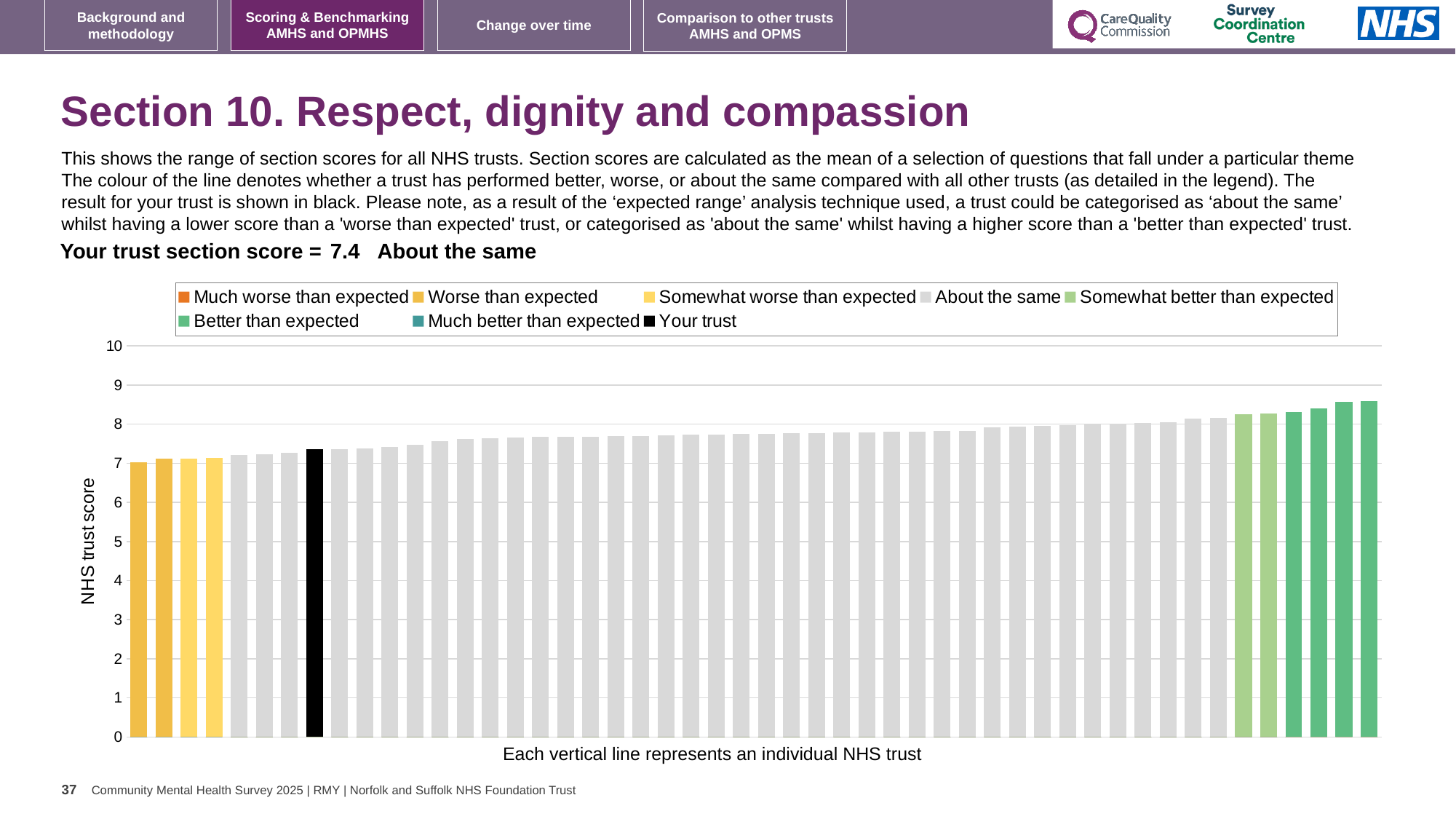
Is the value of the rightmost bar greater or less than 8? greater What is the section score for your trust shown on the slide? 7.4 Is the value for your trust (the black bar) greater or less than 7? greater What kind of chart is shown on the slide? bar chart How many entries does the chart legend list? 8 What is the highest value shown on the y axis? 10 Do the bar values rise or fall from left to right along the x axis? rise Which is larger, the leftmost bar or the rightmost bar? the rightmost bar Which category is your trust placed in for this section? About the same What colour is the bar representing your trust? black What is the label on the y axis of the chart? NHS trust score Is the value of the leftmost bar greater or less than 8? less